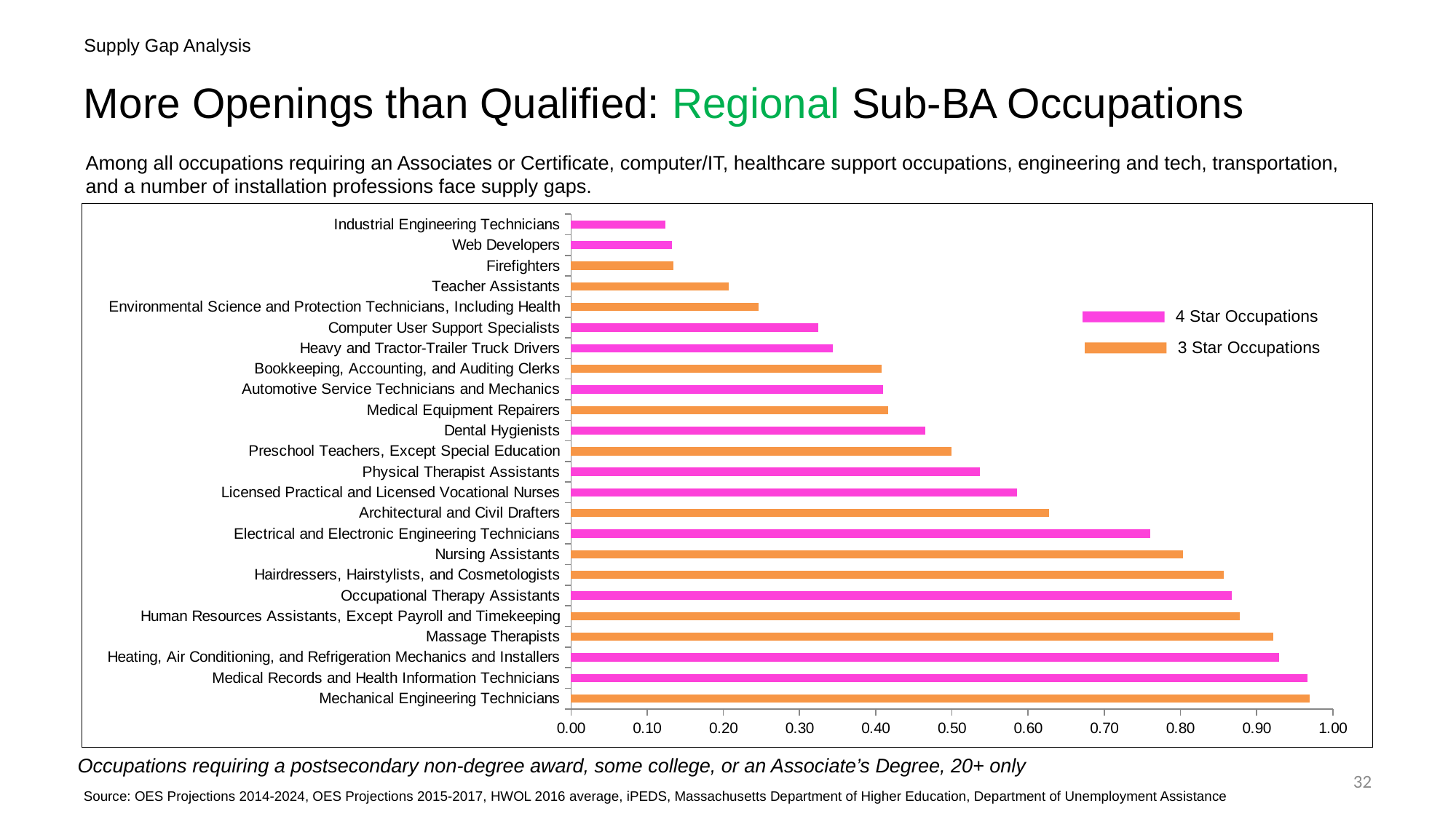
Which legend series is shown in orange? 3 Star Occupations Is the value for Heavy and Tractor-Trailer Truck Drivers greater or less than 0.40? less Is the value for Dental Hygienists greater or less than 0.50? less Which has the larger value, Massage Therapists or Dental Hygienists? Massage Therapists What kind of chart is shown on the slide? Bar chart Is the value for Industrial Engineering Technicians greater or less than 0.20? less How many occupations are plotted in the chart? 24 How many series does the legend list? 2 Which has the larger value, Web Developers or Nursing Assistants? Nursing Assistants